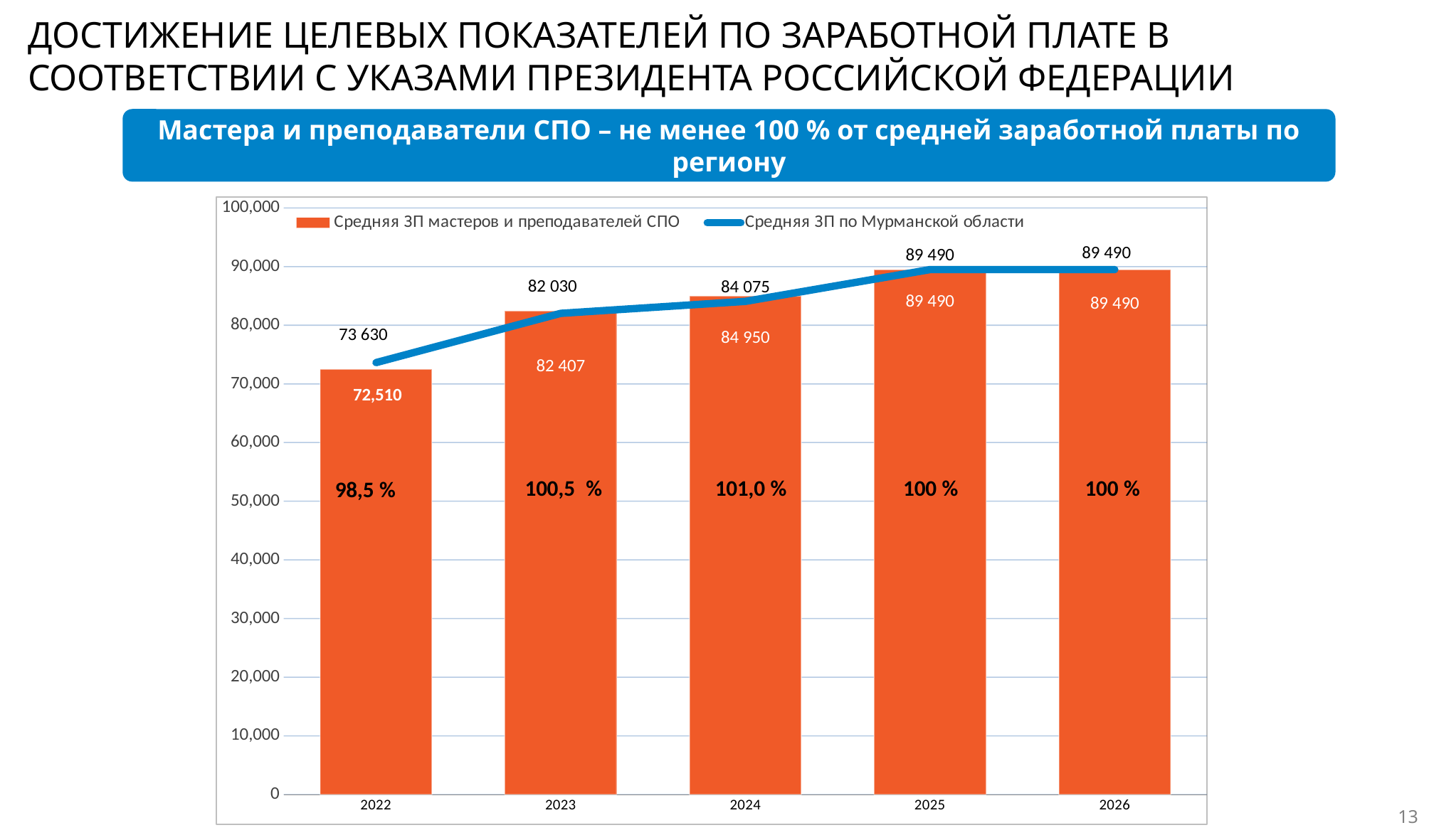
What is the value of the line series Средняя ЗП по Мурманской области for 2022? 73 630 What is the difference between the line value (82 030) and the bar value (82 407) for 2023? 377 What is the value of the bar for 2022 (Средняя ЗП мастеров и преподавателей СПО)? 72,510 For 2022, which is larger: the bar value for Средняя ЗП мастеров и преподавателей СПО or the line value for Средняя ЗП по Мурманской области? Средняя ЗП по Мурманской области What is the value of the bar for 2023 (Средняя ЗП мастеров и преподавателей СПО)? 82 407 Do the bar values for Средняя ЗП мастеров и преподавателей СПО rise or fall from 2022 to 2025? Rise What percentage is printed inside the bar for 2024? 101,0 % What is the value of the line series Средняя ЗП по Мурманской области for 2024? 84 075 How many series does the chart legend list? 2 How many years are shown on the x axis of the chart? 5 Which year has the lowest bar value for Средняя ЗП мастеров и преподавателей СПО? 2022 What kind of chart is shown on the slide? Combined bar and line chart